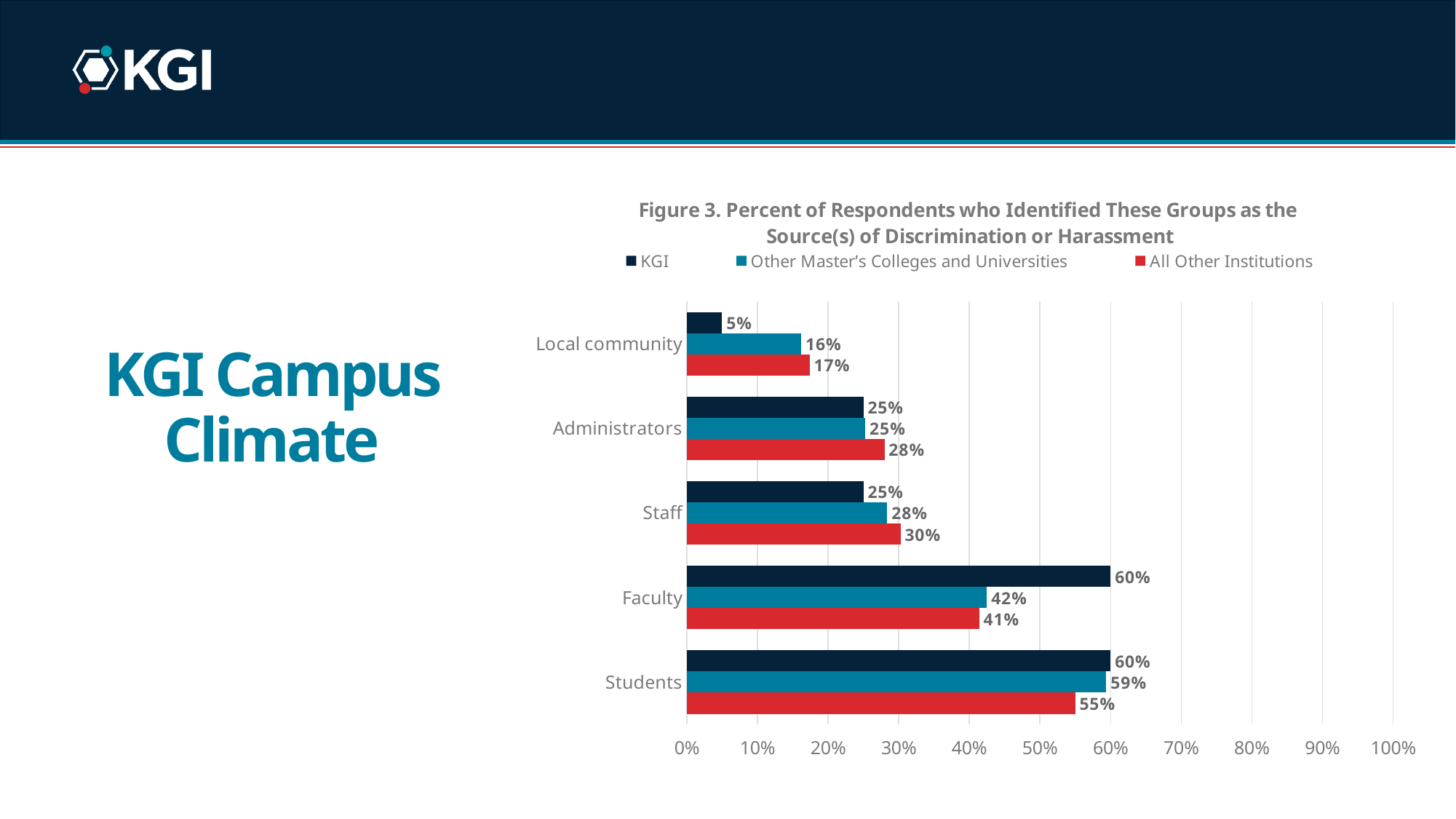
What is the value for Administrators in the All Other Institutions series? 28% What colour represents the KGI series in the chart? Dark navy blue What is the difference between the KGI value and the All Other Institutions value for Faculty? 19% What is the value for Faculty in the Other Master's Colleges and Universities series? 42% What is the value for Students in the All Other Institutions series? 55% How many categories are shown on the chart? 5 Which category has the lowest value in the KGI series? Local community How many series does the legend list? 3 What kind of chart is shown on the slide? Bar chart What percent of KGI respondents identified the local community as a source of discrimination or harassment? 5% For Staff, which is larger: the KGI value or the All Other Institutions value? All Other Institutions Which category has the highest value in the All Other Institutions series? Students